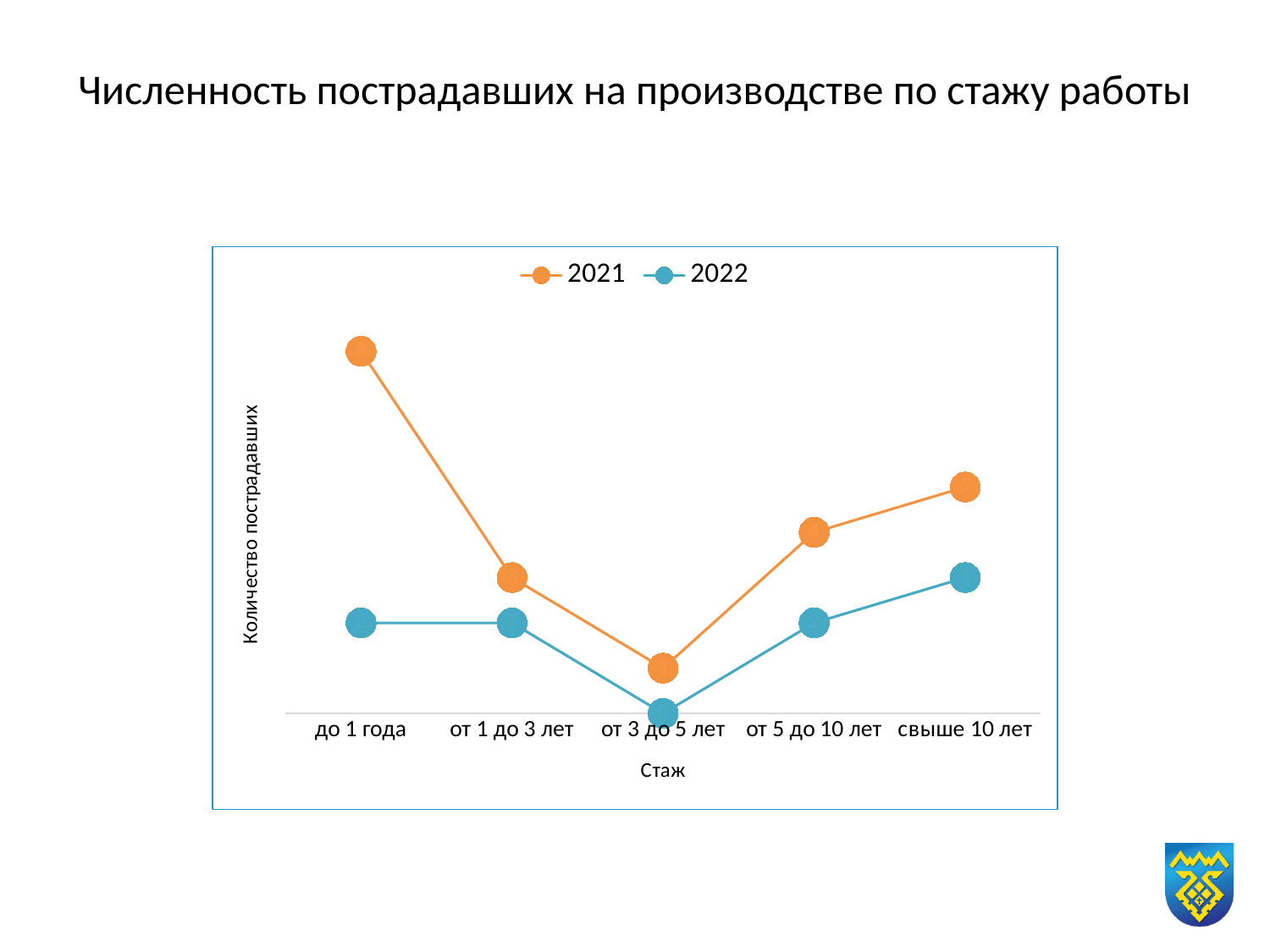
How many categories are shown on the x axis? 5 Do the 2021 values rise or fall from 'от 3 до 5 лет' to 'свыше 10 лет'? Rise What kind of chart is shown on the slide? Line chart For the 2021 series, which category has the highest value? до 1 года What is the label of the x axis? Стаж For the category 'свыше 10 лет', which series has the larger value, 2021 or 2022? 2021 For the 2021 series, which category has the lowest value? от 3 до 5 лет For the 2022 series, which category has the highest value? свыше 10 лет For the category 'до 1 года', which series has the larger value, 2021 or 2022? 2021 How many series does the legend list? 2 For the 2022 series, which category has the lowest value? от 3 до 5 лет What is the title of the chart on the slide? Численность пострадавших на производстве по стажу работы